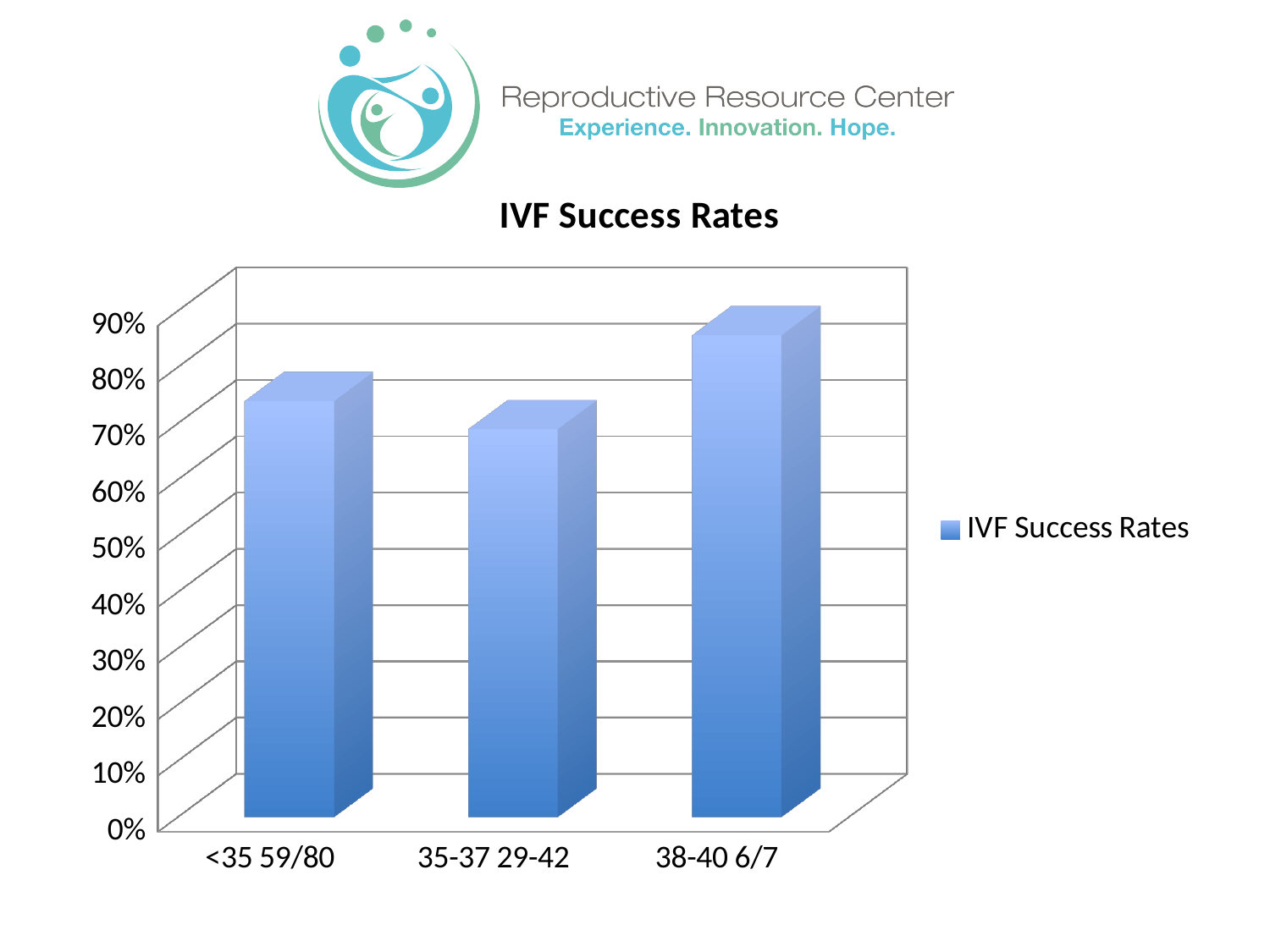
How many series does the legend list? 1 What is the title of the chart? IVF Success Rates Which has a higher IVF success rate, 38-40 6/7 or <35 59/80? 38-40 6/7 Which category has the highest IVF success rate? 38-40 6/7 Is the value for 35-37 29-42 greater or less than 60%? greater What kind of chart is shown on the slide? bar chart Is the value for <35 59/80 greater or less than 80%? less Which category has the lowest IVF success rate? 35-37 29-42 Is the value for 38-40 6/7 greater or less than 80%? greater Which has a higher IVF success rate, <35 59/80 or 35-37 29-42? <35 59/80 How many categories are shown on the x axis of the chart? 3 What is the name of the series shown in the legend? IVF Success Rates